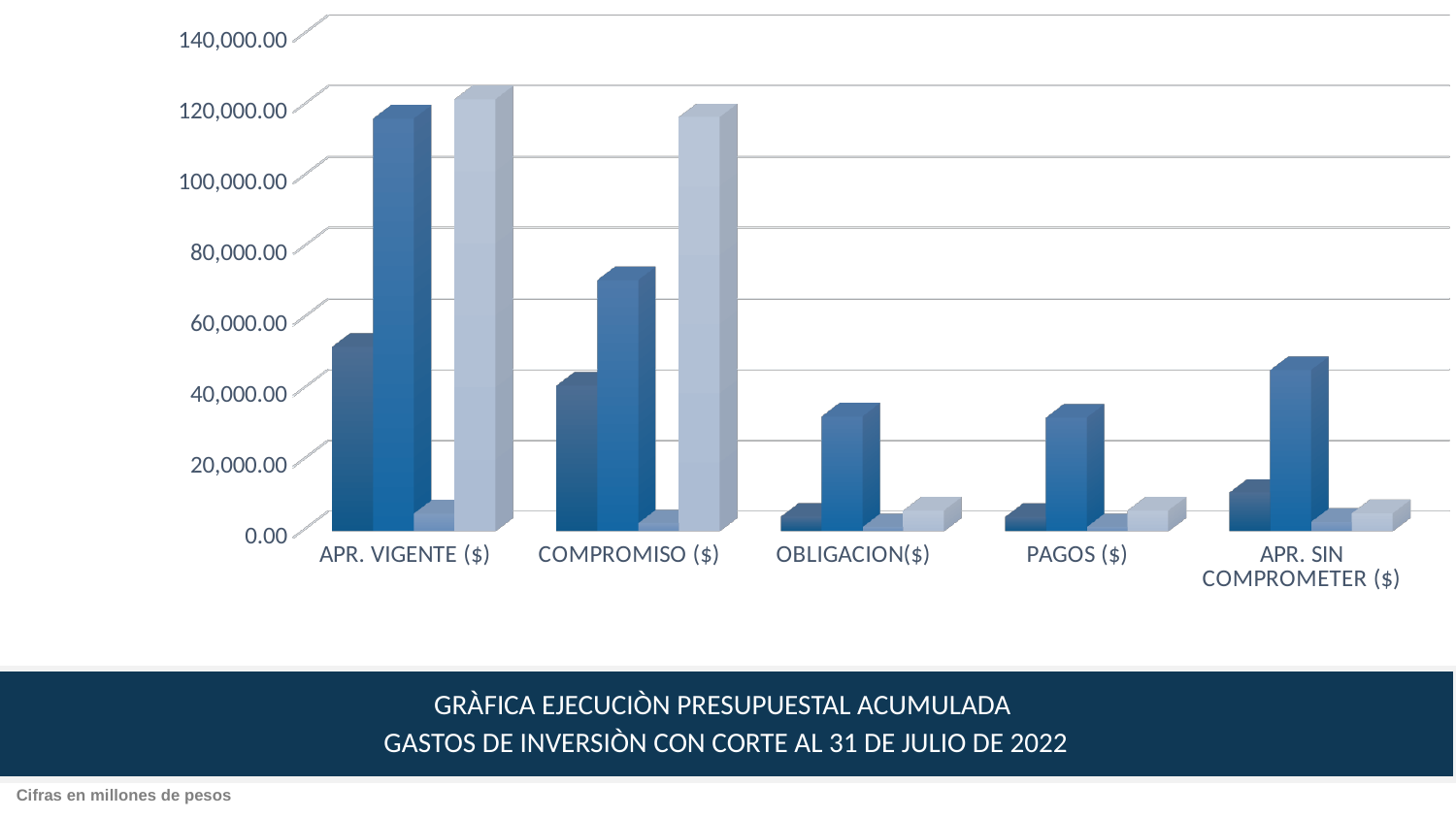
Is the second bar from the left in the COMPROMISO ($) group greater or less than 60,000.00? greater Is the tallest bar for PAGOS ($) greater or less than 20,000.00? greater Which category has the tallest bar in the chart? APR. VIGENTE ($) In what units are the figures in the chart expressed, according to the note on the slide? millones de pesos Which category has a taller tallest bar, APR. VIGENTE ($) or OBLIGACION($)? APR. VIGENTE ($) Is the tallest bar for APR. VIGENTE ($) greater or less than 100,000.00? greater What is the title shown below the chart? GRÀFICA EJECUCIÒN PRESUPUESTAL ACUMULADA GASTOS DE INVERSIÒN CON CORTE AL 31 DE JULIO DE 2022 What kind of chart is shown on the slide? bar chart How many bars are plotted for each category in the chart? 4 How many categories are shown along the x axis of the chart? 5